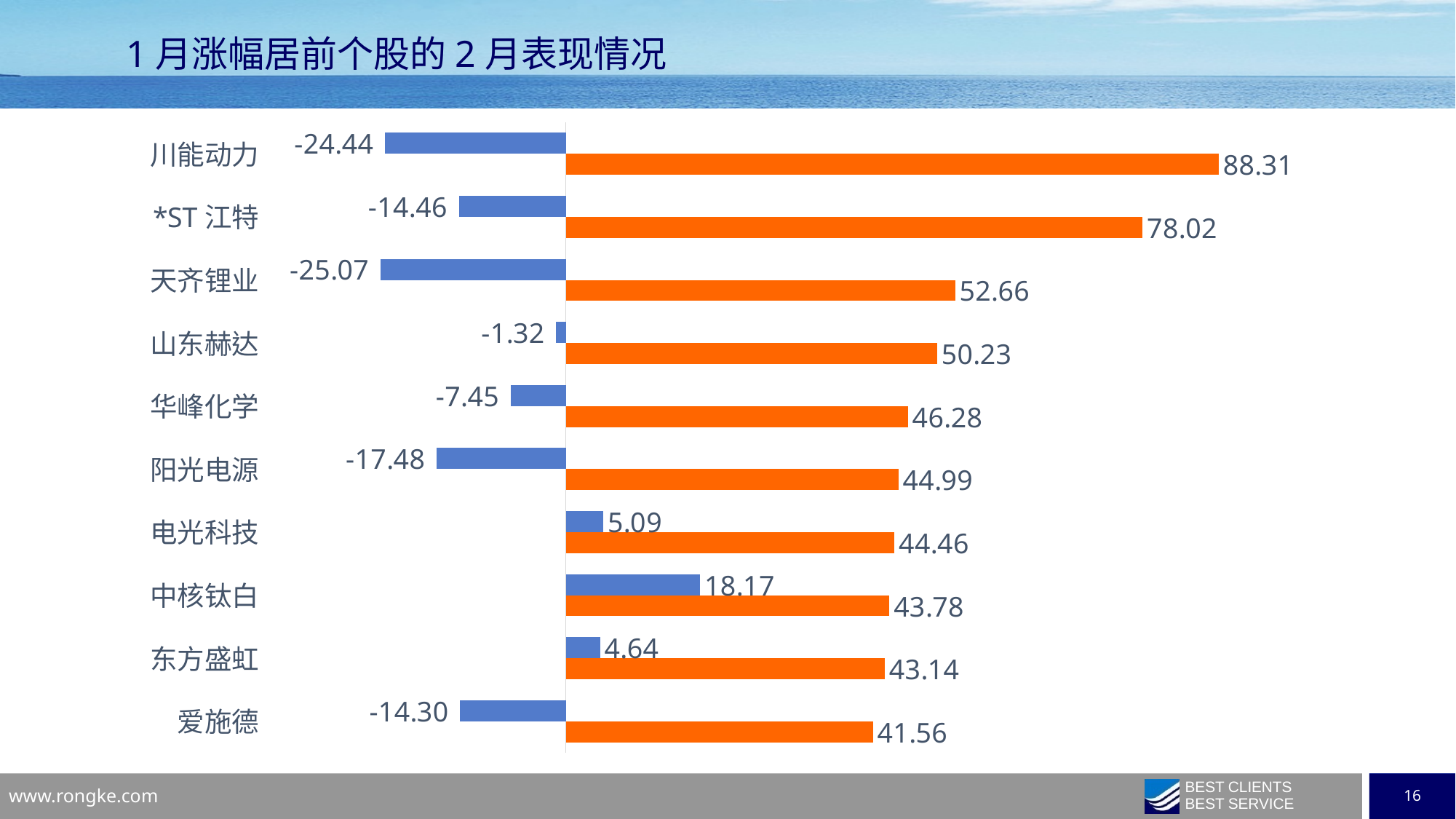
Which stock has the lowest blue-bar value? 天齐锂业 Which stock has the highest orange-bar value? 川能动力 How many stocks (categories) are plotted in the chart? 10 What kind of chart is shown on the slide? bar chart Which stock has the highest blue-bar value? 中核钛白 What is the value of the blue bar for 天齐锂业? -25.07 What is the title of the chart on the slide? 1 月涨幅居前个股的 2 月表现情况 Which has a larger blue-bar value, 电光科技 or 东方盛虹? 电光科技 What is the value of the orange bar for 川能动力? 88.31 What is the difference between the orange-bar values of 川能动力 and *ST 江特? 10.29 What is the value of the orange bar for 爱施德? 41.56 What is the value of the blue bar for 中核钛白? 18.17